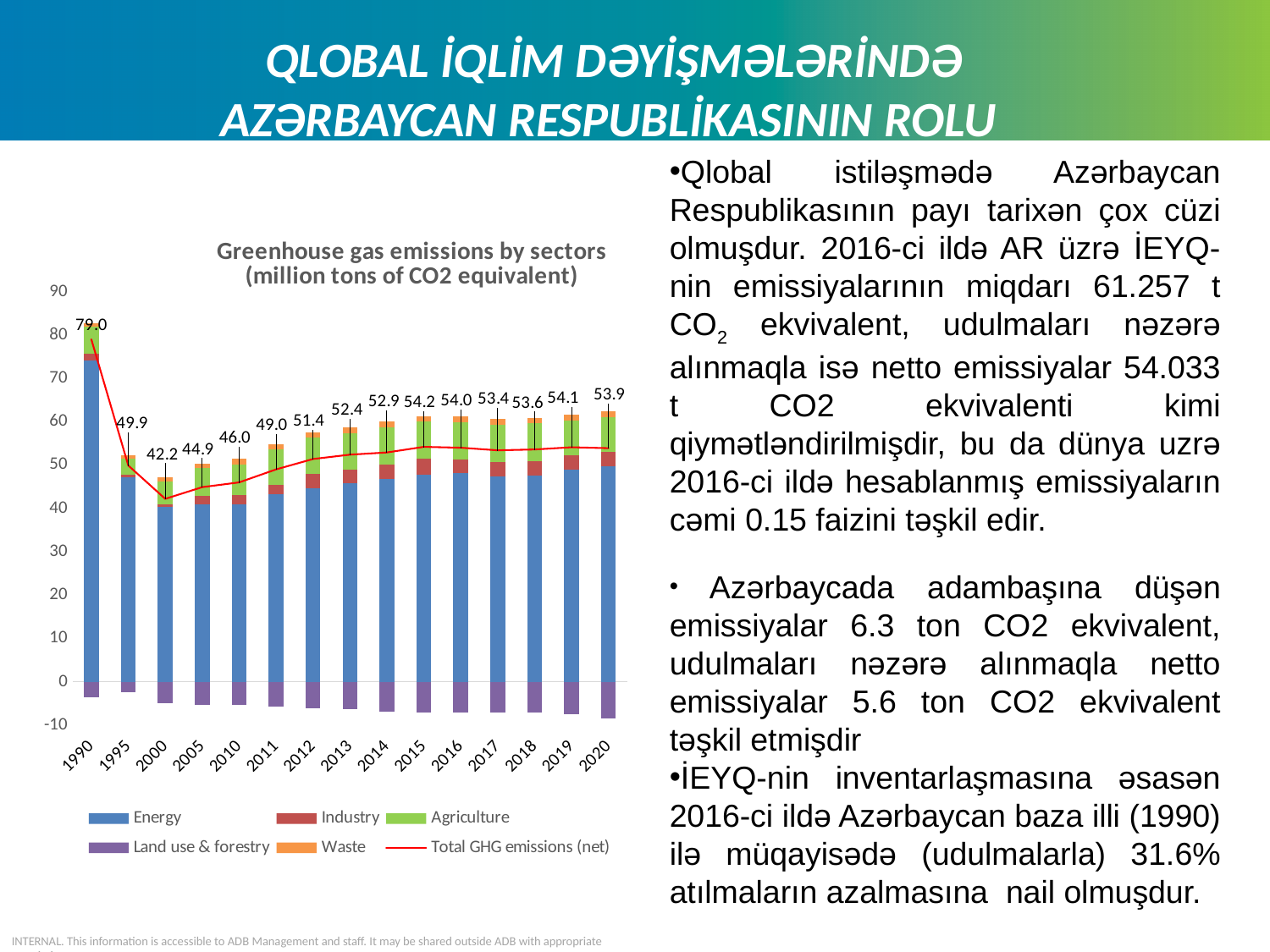
Which year has the lowest Total GHG emissions (net)? 2000 What is the title of the chart? Greenhouse gas emissions by sectors (million tons of CO2 equivalent) How many years are shown on the x axis? 15 What is the Total GHG emissions (net) value for 2020? 53.9 How many series does the legend list? 6 What is the Total GHG emissions (net) value for 1990? 79.0 What is the Total GHG emissions (net) value for 2012? 51.4 Is the Energy bar for 1990 greater or less than 70? greater Which year has the highest Total GHG emissions (net)? 1990 What is the difference between the Total GHG emissions (net) in 1990 and in 2000? 36.8 Do the Total GHG emissions (net) values rise or fall from 2000 to 2015? rise Which year has a larger Total GHG emissions (net) value, 2015 or 2017? 2015